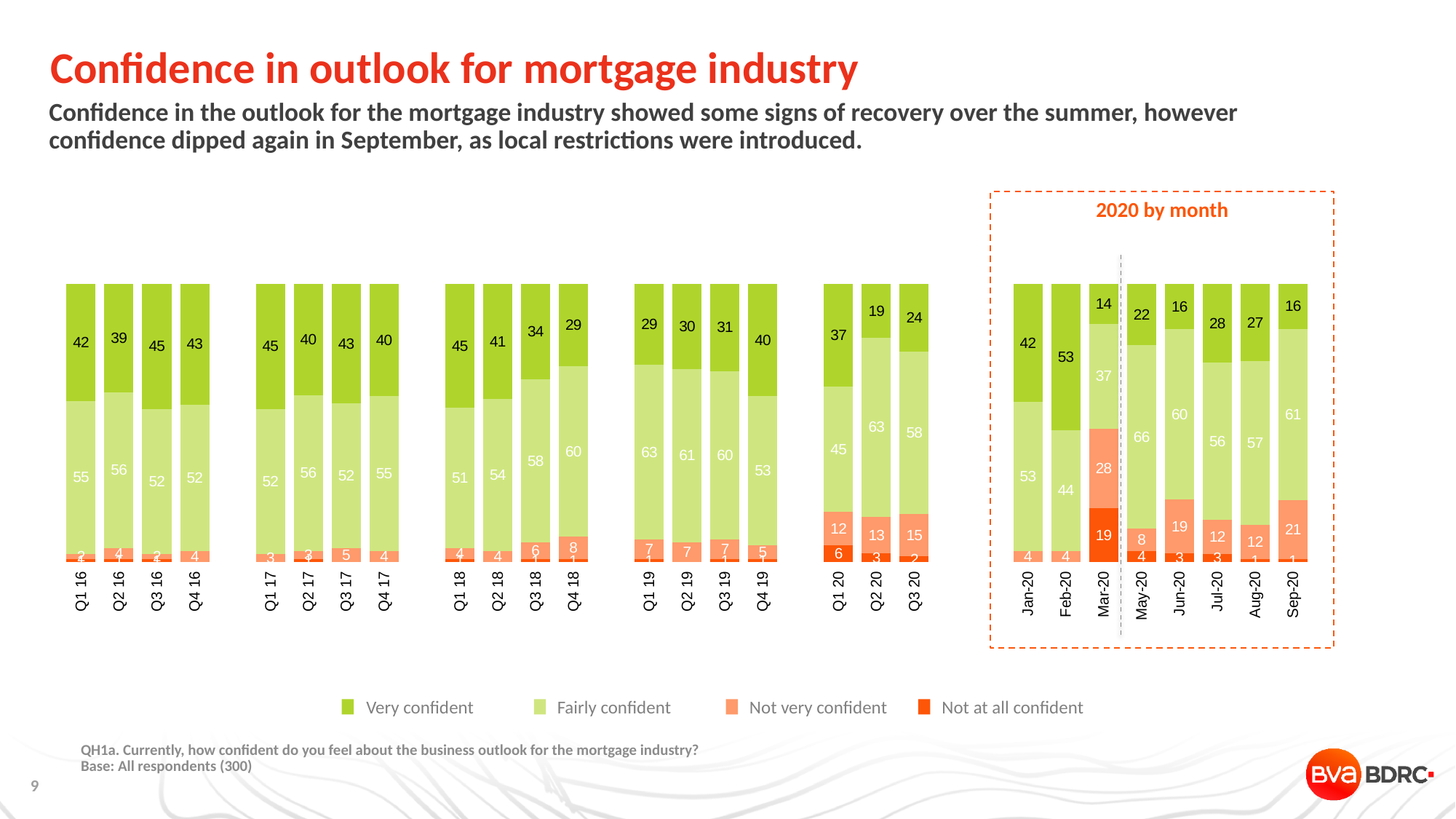
What is the 'Fairly confident' value for Q1 19? 63 Which period has the lowest 'Very confident' value? Mar-20 What kind of chart is shown on the slide? Stacked bar chart How many monthly bars are shown in the '2020 by month' section? 8 Which is larger, the 'Very confident' value for Q1 20 or for Q2 20? Q1 20 How many series does the legend list? 4 What is the 'Very confident' value for Feb-20? 53 What is the difference between the 'Very confident' values for Aug-20 and Sep-20? 11 Which period has the highest 'Very confident' value? Feb-20 What is the total of the Mar-20 stacked bar? 98 What is the 'Not very confident' value for Sep-20? 21 What is the 'Not at all confident' value for Mar-20? 19